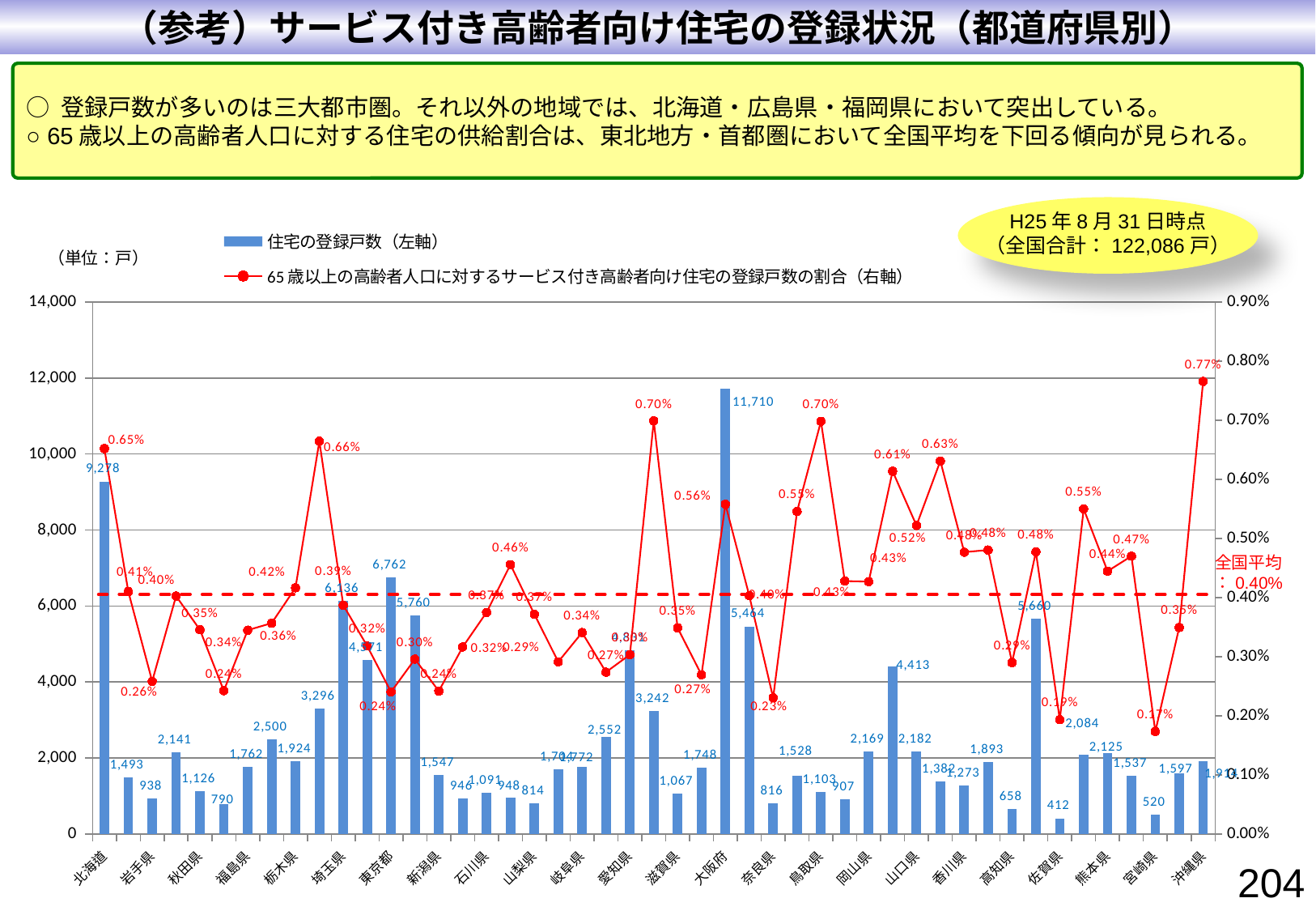
What is the ratio (right axis) for 宮崎県? 0.17% What is the difference in registered housing units between 大阪府 and 北海道? 2,432 Which prefecture has the highest number of registered housing units? 大阪府 What is the number of registered housing units for 北海道? 9,278 How many series does the legend list? 2 Which prefecture has the highest ratio on the right axis? 沖縄県 What value does the dashed horizontal line labelled 全国平均 represent? 0.40% Which prefecture has the lowest number of registered housing units? 佐賀県 Which has more registered housing units, 埼玉県 or 東京都? 東京都 What is the number of registered housing units for 東京都? 6,762 What is the ratio of registered units to the population aged 65 and over (right axis) for 沖縄県? 0.77% What is the number of registered housing units (住宅の登録戸数) for 大阪府? 11,710